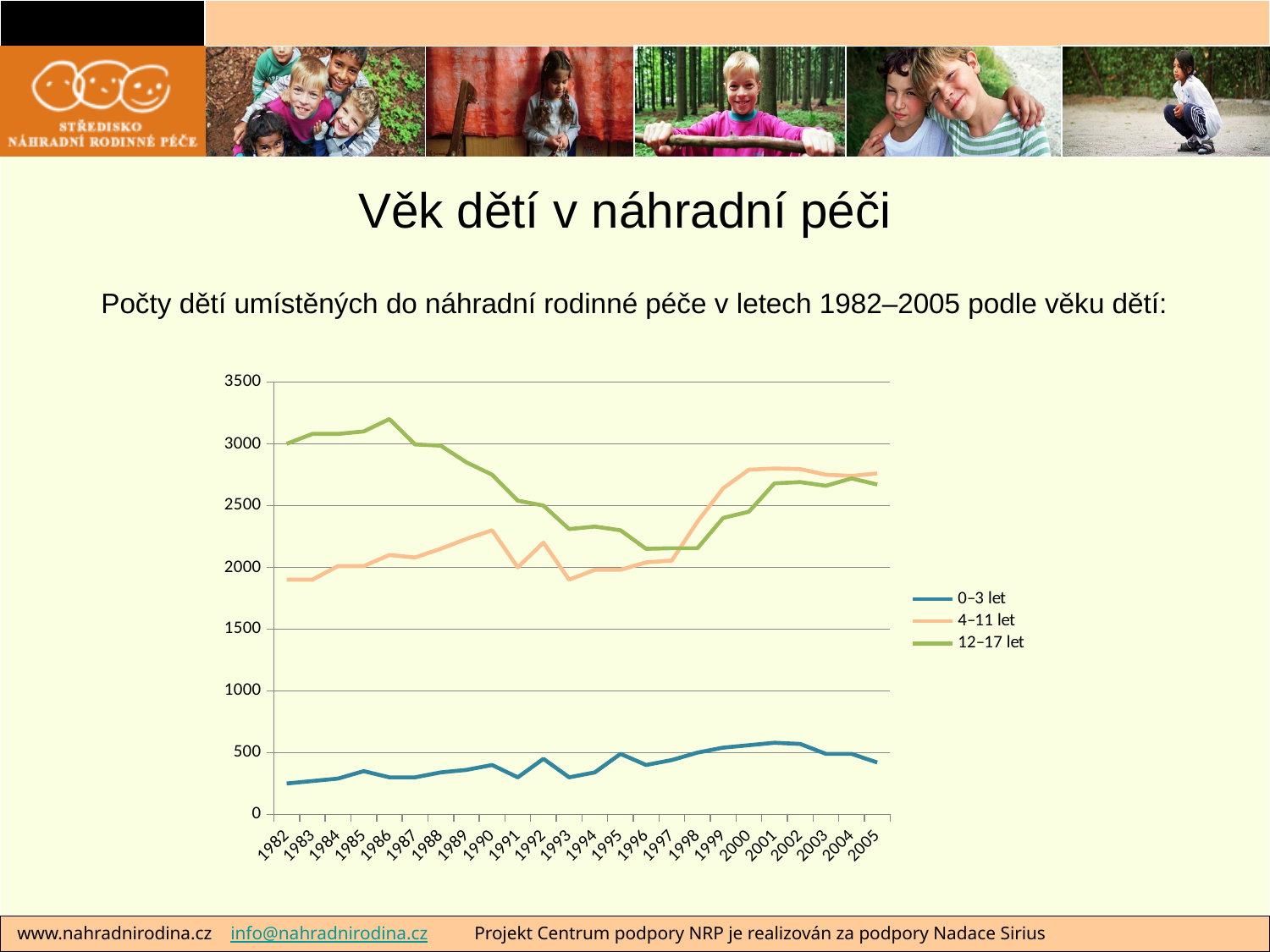
In 1982, which series has the larger value, 4–11 let or 12–17 let? 12–17 let Is the value for 12–17 let in 1986 greater or less than 3000? greater In which year does the 12–17 let series reach its highest value? 1986 Which series has the lowest values across all years? 0–3 let How many series does the legend list? 3 Is the value for 0–3 let in 1982 greater or less than 500? less Is the value for 4–11 let in 1993 greater or less than 2000? less How many years are plotted along the x axis? 24 Does the 12–17 let series rise or fall between 1986 and 1996? fall In 2000, which series has the larger value, 4–11 let or 12–17 let? 4–11 let What kind of chart is shown on the slide? line chart